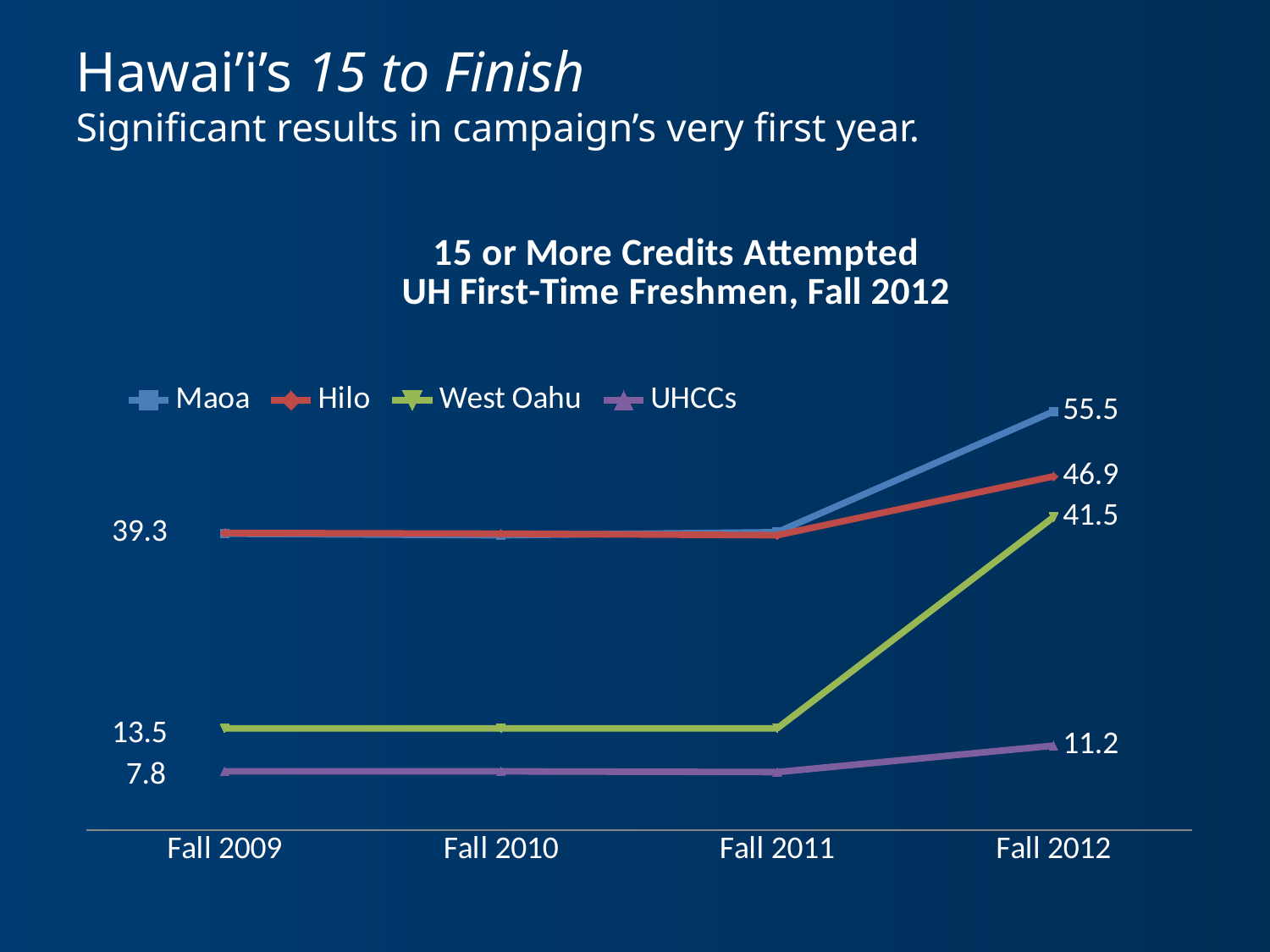
Which series has the lowest value in Fall 2012? UHCCs How many time points are shown on the x axis? 4 Which series has the highest value in Fall 2012? Maoa What is the value for UHCCs in Fall 2009? 7.8 What is the value for Hilo in Fall 2012? 46.9 What type of chart is shown on the slide? line chart What is the value for Maoa in Fall 2012? 55.5 What is the value for West Oahu in Fall 2012? 41.5 What is the title of the chart? 15 or More Credits Attempted UH First-Time Freshmen, Fall 2012 How many series does the legend list? 4 By how much did the West Oahu value increase from Fall 2009 (13.5) to Fall 2012 (41.5)? 28 Does the West Oahu line rise or fall between Fall 2011 and Fall 2012? rise